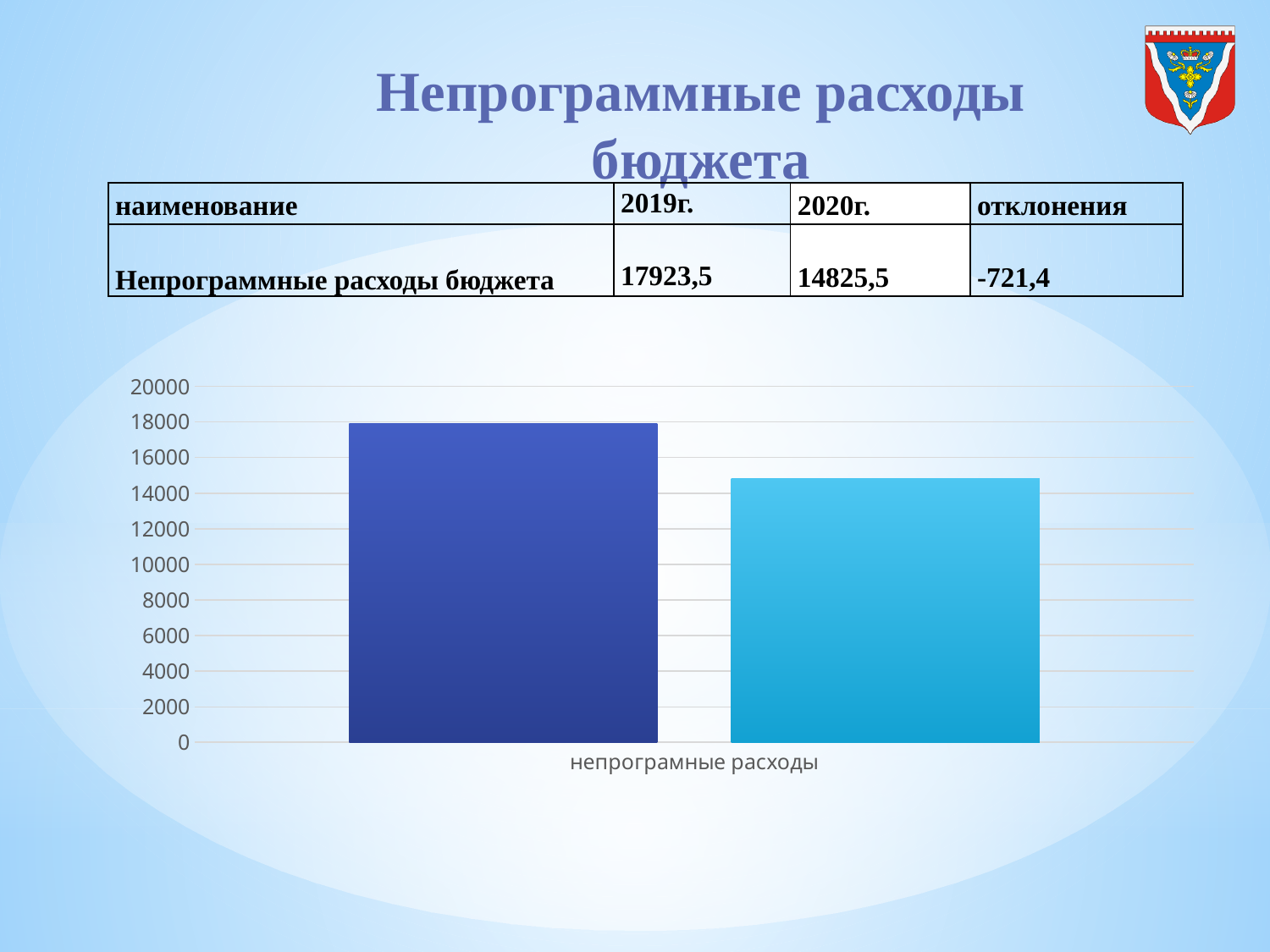
Is the value of the right (light blue) bar greater or less than 14000? greater How many bars are plotted in the chart? 2 Is the value of the right (light blue) bar greater or less than 16000? less What kind of chart is shown on the slide? bar chart What is the category label shown under the bars on the x axis? непрограмные расходы Which bar is taller, the left (dark blue) bar or the right (light blue) bar? the left (dark blue) bar Do the bar values rise or fall from left to right? fall What is the highest value shown on the vertical axis? 20000 According to the table above the chart, what is the value of Непрограммные расходы бюджета for 2019г.? 17923,5 Is the value of the left (dark blue) bar greater or less than 16000? greater According to the table above the chart, what is the value of Непрограммные расходы бюджета for 2020г.? 14825,5